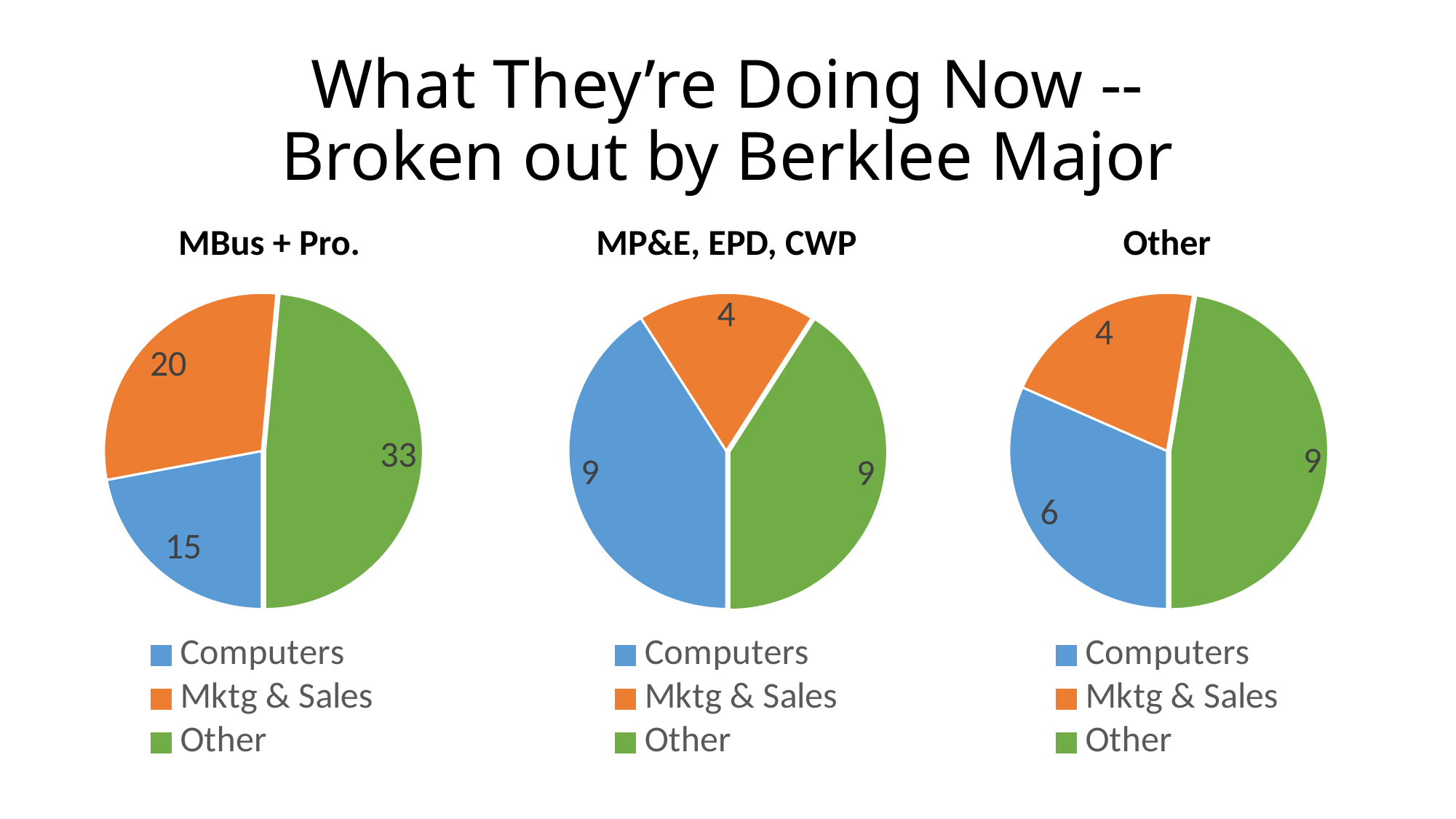
In the MBus + Pro. chart, what is the difference between the Other value and the Computers value? 18 In the MP&E, EPD, CWP chart, what is the total of all slices? 22 In the Other chart (rightmost), what is the value for Computers? 6 In the Other chart (rightmost), which is larger, Computers or Mktg & Sales? Computers What type of chart is used for MBus + Pro.? Pie chart How many slices does the MP&E, EPD, CWP pie chart have? 3 In the MBus + Pro. chart, which category has the largest slice? Other In the Other chart (rightmost), which category has the smallest slice? Mktg & Sales In the MBus + Pro. chart, what colour is the Mktg & Sales slice? Orange In the MP&E, EPD, CWP chart, what is the value for Mktg & Sales? 4 In the MBus + Pro. chart, what is the value for Other? 33 In the MBus + Pro. chart, what is the value for Computers? 15